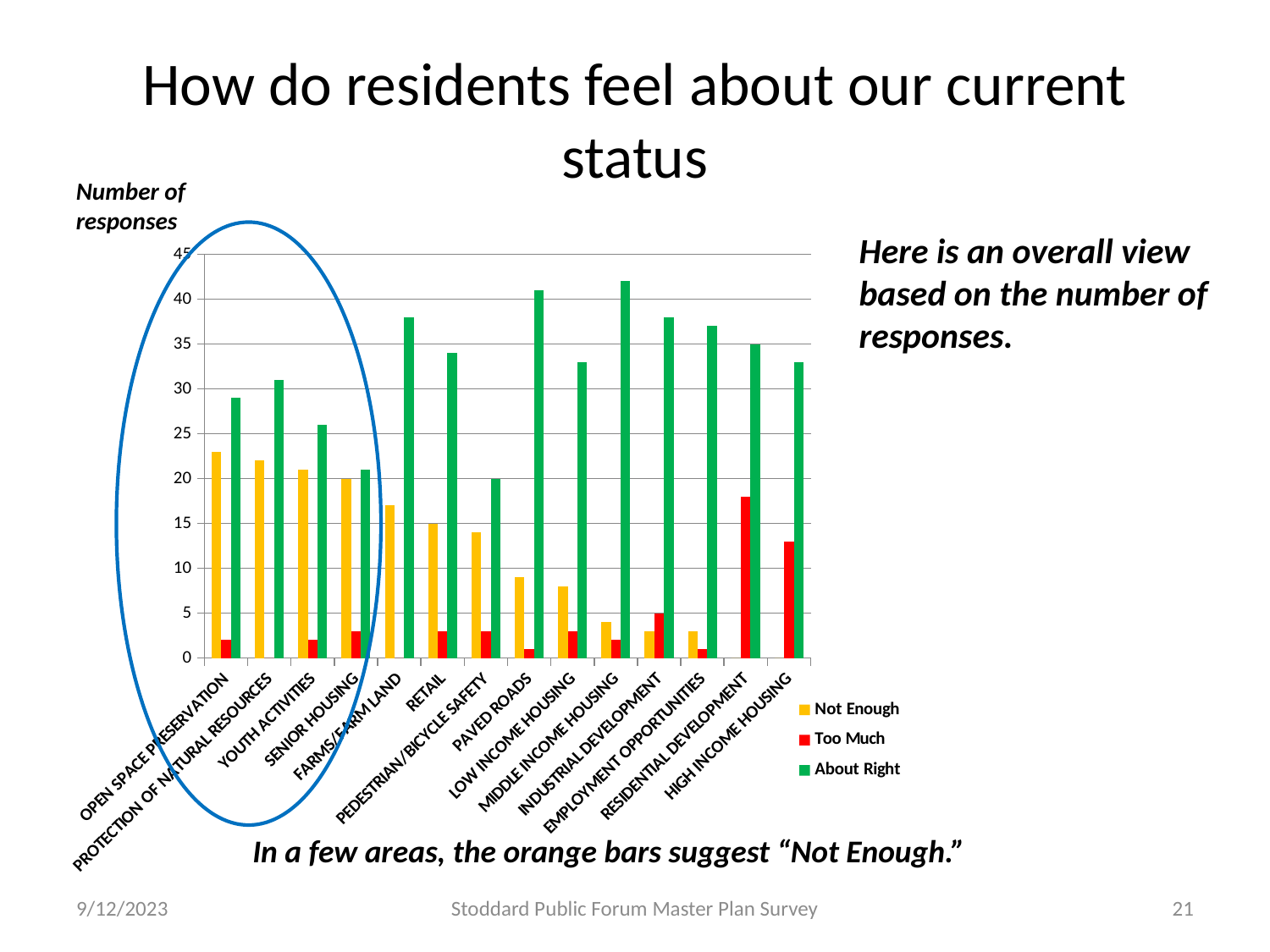
What colour represents the 'Too Much' series in the chart? red Do the 'Not Enough' values generally rise or fall moving from left to right along the x axis? fall Is the 'Not Enough' value for Farms/Farm Land greater or less than 20? less Which category has the lowest 'About Right' value? Pedestrian/Bicycle Safety Is the 'Too Much' value for Residential Development greater or less than 15? greater Is the 'Not Enough' value for Open Space Preservation greater or less than 20? greater How many series does the chart legend list? 3 How many categories are shown along the x axis of the chart? 14 Which is larger, the 'About Right' value for Retail or the 'About Right' value for Pedestrian/Bicycle Safety? Retail Which category has the highest 'Too Much' value? Residential Development What kind of chart is shown on the slide? bar chart